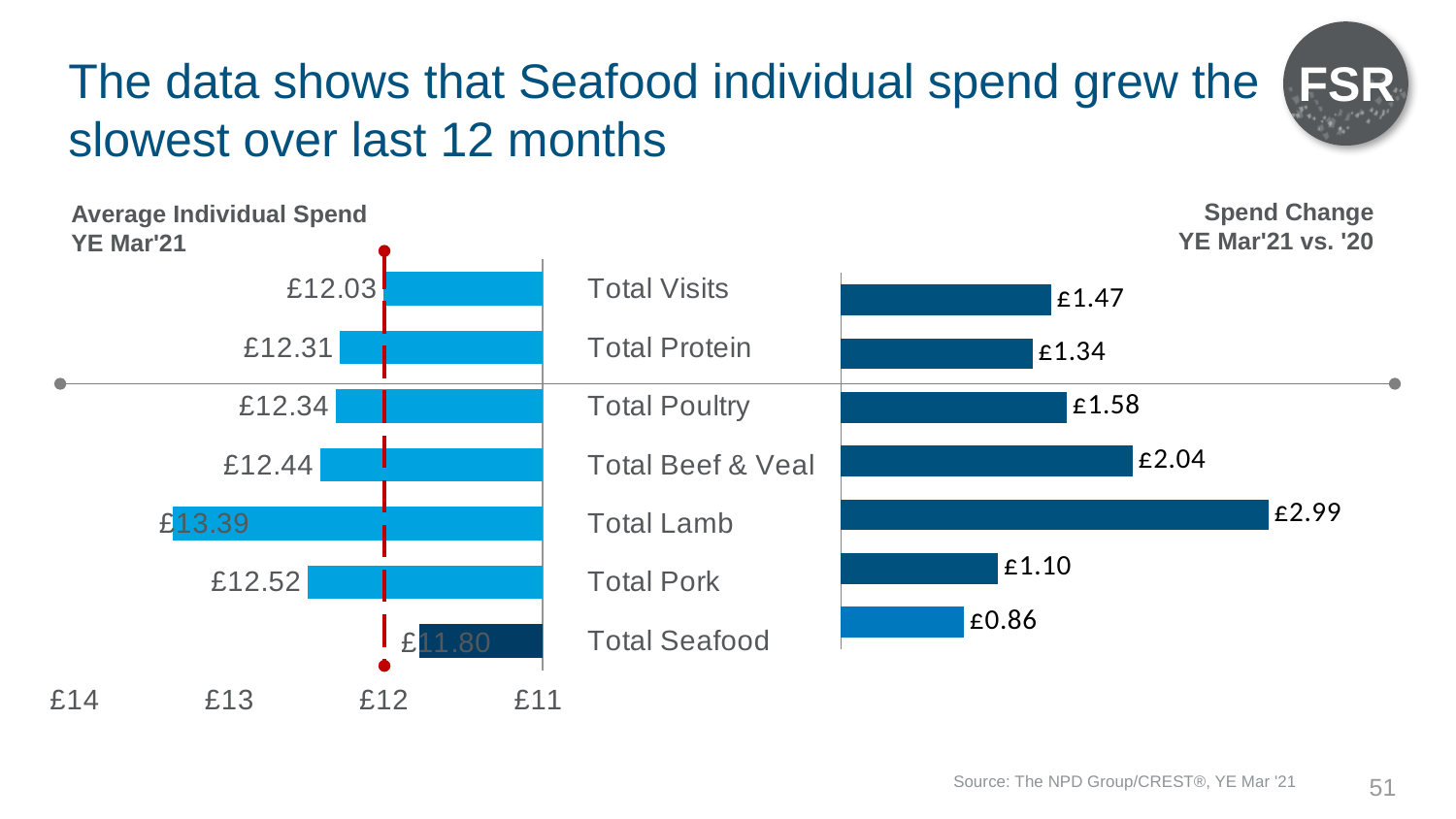
In the Spend Change YE Mar'21 vs. '20 chart, which category has the lowest value? Total Seafood What kind of chart is the Spend Change YE Mar'21 vs. '20 chart? Bar chart How many categories are shown in the Average Individual Spend YE Mar'21 chart? 7 In the Spend Change YE Mar'21 vs. '20 chart, which is larger, Total Poultry or Total Protein? Total Poultry In the Spend Change YE Mar'21 vs. '20 chart, what is the value for Total Beef & Veal? £2.04 In the Spend Change YE Mar'21 vs. '20 chart, what is the value for Total Pork? £1.10 In the Average Individual Spend YE Mar'21 chart, what is the difference between Total Pork and Total Visits? £0.49 In the Spend Change YE Mar'21 vs. '20 chart, which category has the highest value? Total Lamb In the Average Individual Spend YE Mar'21 chart, which category has the lowest value? Total Seafood In the Average Individual Spend YE Mar'21 chart, what is the value for Total Lamb? £13.39 In the Average Individual Spend YE Mar'21 chart, what is the value for Total Seafood? £11.80 In the Spend Change YE Mar'21 vs. '20 chart, what is the difference between Total Lamb and Total Seafood? £2.13